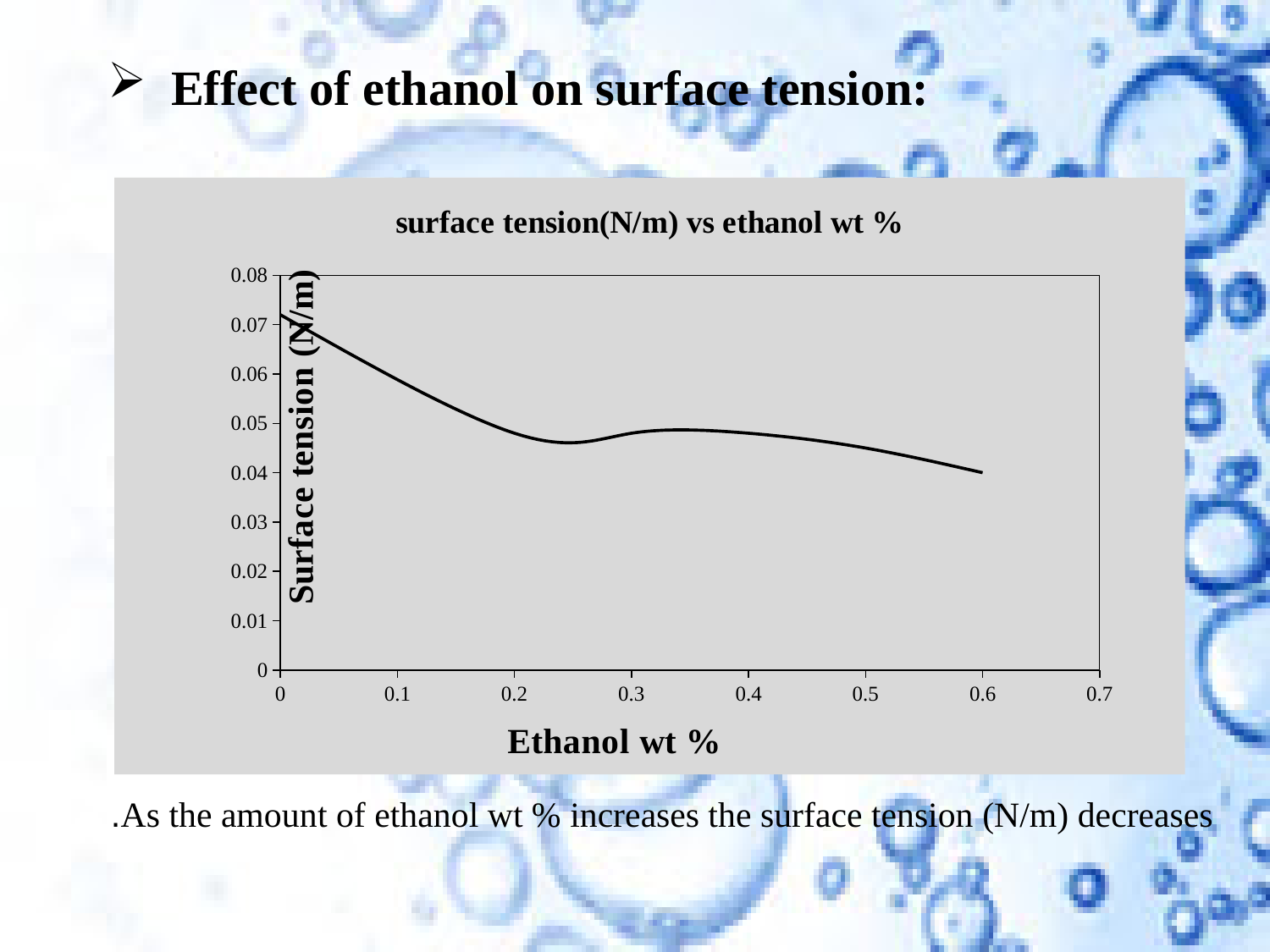
What is the label of the x axis? Ethanol wt % What is the title of the chart? surface tension(N/m) vs ethanol wt % Is the surface tension at ethanol wt % 0 greater or less than 0.06? greater What is the maximum value shown on the y axis? 0.08 At which ethanol wt % is the surface tension highest? 0 At which ethanol wt % is the surface tension lowest? 0.6 Does surface tension rise or fall overall as ethanol wt % increases along the x axis? fall Is the surface tension at ethanol wt % 0.2 greater or less than 0.06? less What kind of chart is shown on the slide? line chart Which has the higher surface tension, ethanol wt % 0 or ethanol wt % 0.6? 0 Is the surface tension at ethanol wt % 0.6 greater or less than 0.05? less